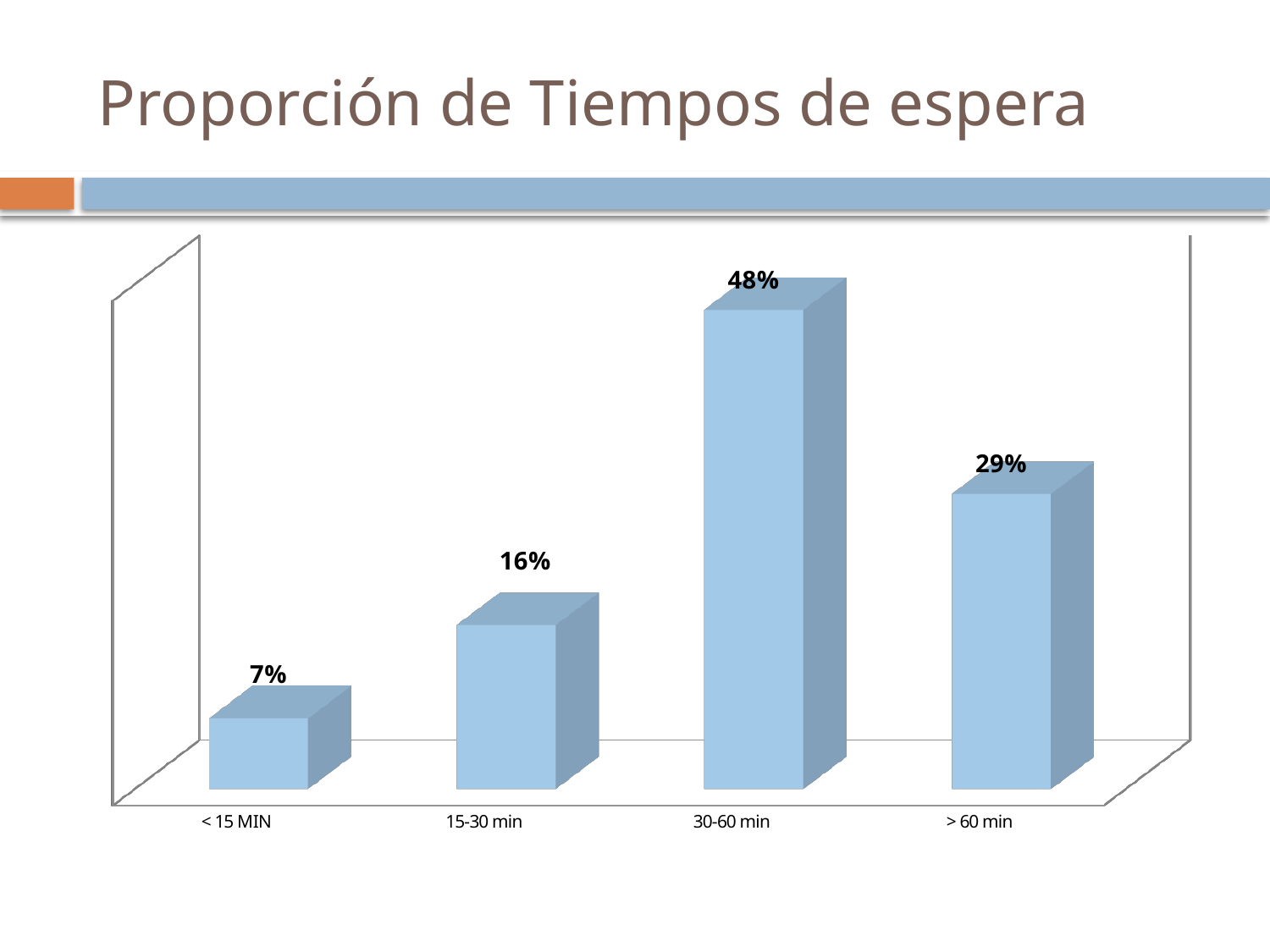
What is the value for the 15-30 min category? 16% What kind of chart is shown on the slide? Bar chart What is the value for the < 15 MIN category? 7% Which category has the highest value? 30-60 min Which is larger, the value for > 60 min or the value for 15-30 min? > 60 min What is the title of the slide containing the chart? Proporción de Tiempos de espera What is the value for the 30-60 min category? 48% How many categories are shown on the x axis? 4 What is the value for the > 60 min category? 29% Which category has the lowest value? < 15 MIN What is the difference between the values for 15-30 min and < 15 MIN? 9% What is the difference between the values for 30-60 min and > 60 min? 19%